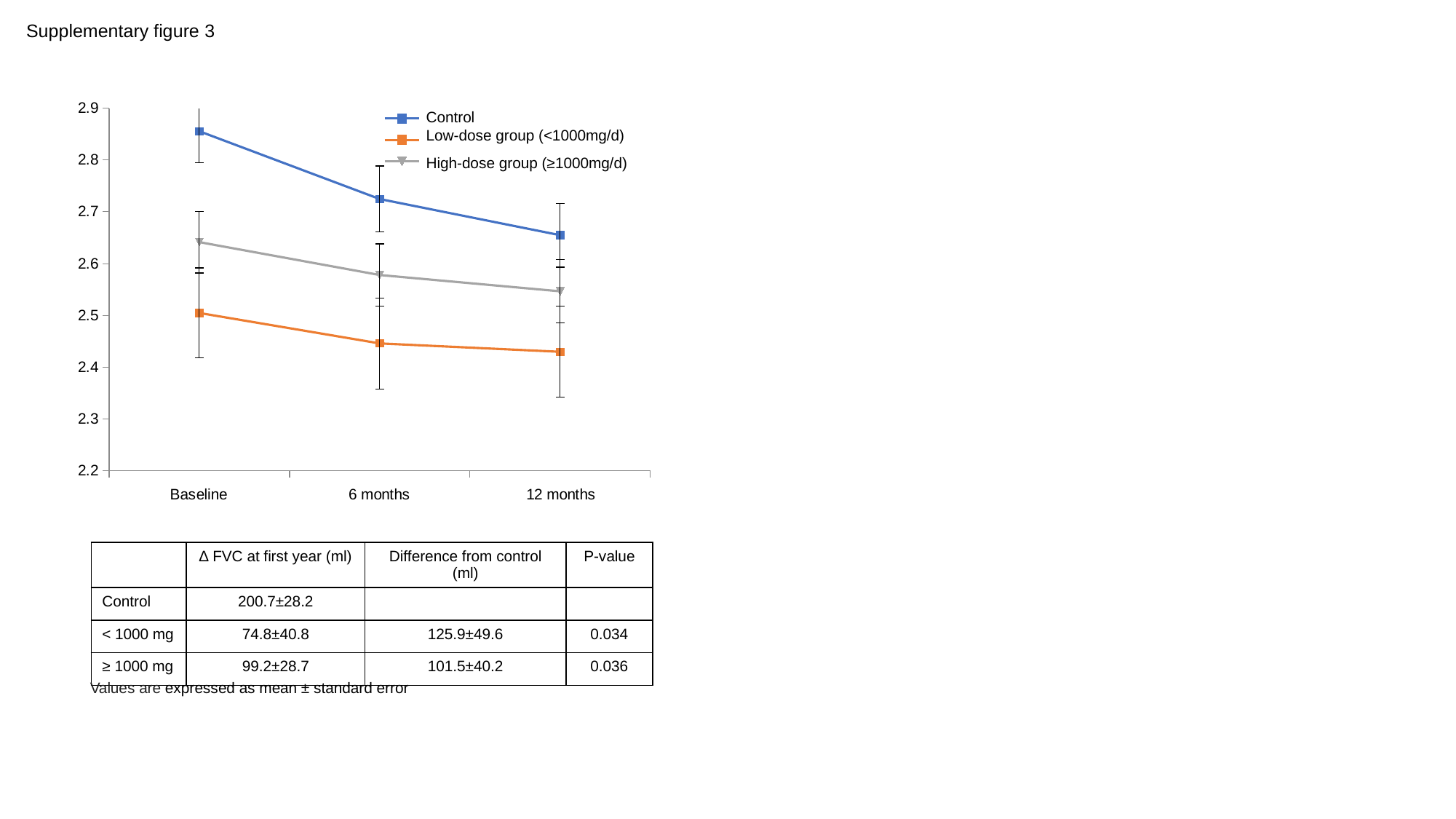
Is the High-dose group (≥1000mg/d) value at 6 months greater or less than 2.6? less At 6 months, which is larger: the Control value or the High-dose group (≥1000mg/d) value? Control What colour is the Control line in the chart? blue Is the Low-dose group (<1000mg/d) value at 12 months greater or less than 2.5? less How many series does the chart legend list? 3 What is the label of the x-axis category between Baseline and 12 months? 6 months Which series has the highest value at Baseline? Control Which series has the lowest value at 12 months? Low-dose group (<1000mg/d) Does the Control series rise or fall from Baseline to 12 months? fall Is the Control value at Baseline greater or less than 2.8? greater What kind of chart is shown on the slide? line chart How many time points are plotted along the x axis? 3